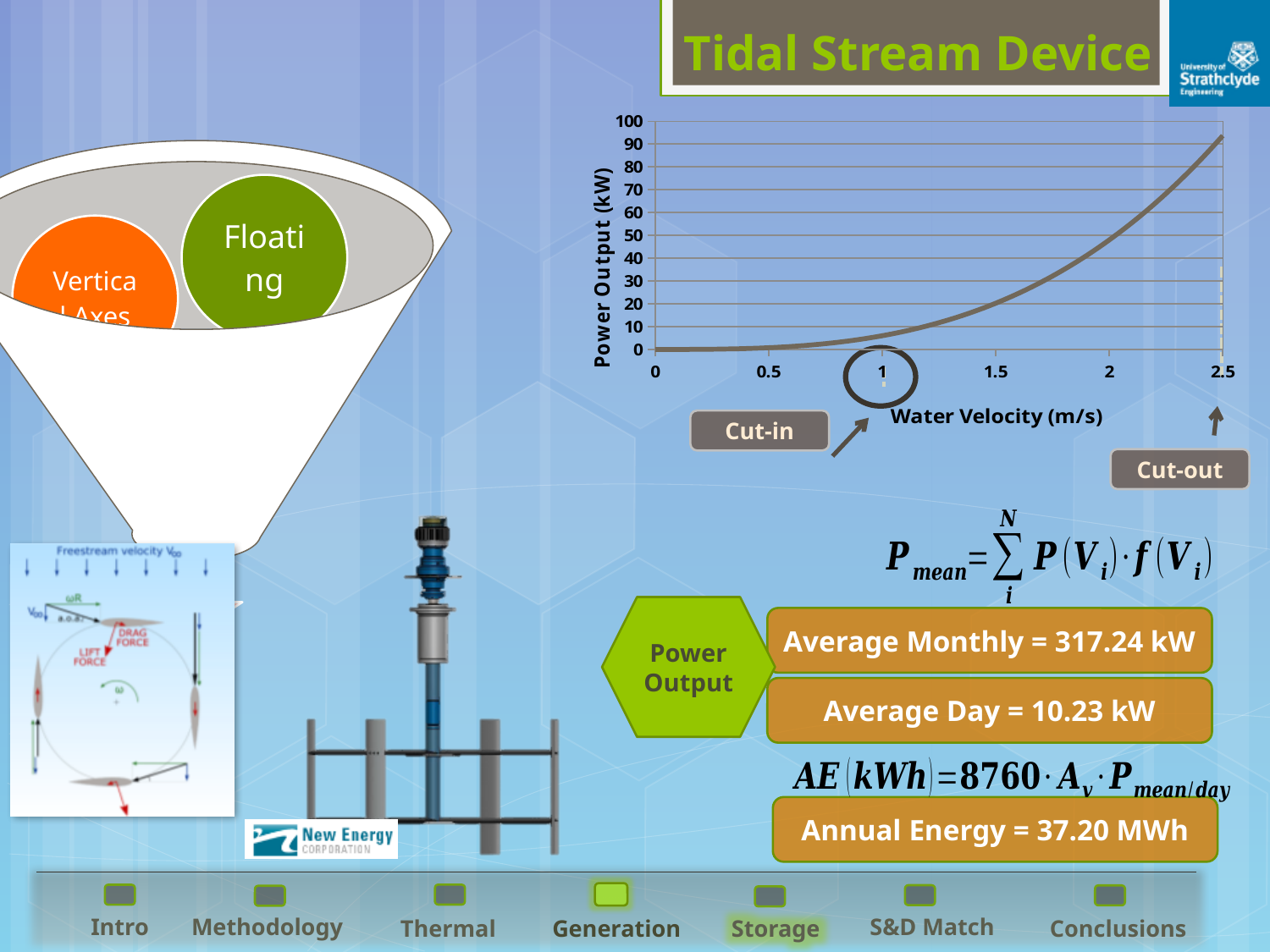
Does the power output rise or fall as water velocity increases along the x axis? rise Which is larger, the power output at 1.5 m/s or at 2 m/s? 2 m/s Is the power output at a water velocity of 2 m/s greater or less than 70 kW? less Is the power output at a water velocity of 1.5 m/s greater or less than 30 kW? less What is the label of the y axis of the chart? Power Output (kW) What is the label of the x axis of the chart? Water Velocity (m/s) At which water velocity shown on the x axis is the power output highest? 2.5 What is the highest value shown on the y axis of the chart? 100 Is the power output at a water velocity of 1 m/s greater or less than 10 kW? less What kind of chart is shown on the slide? line chart